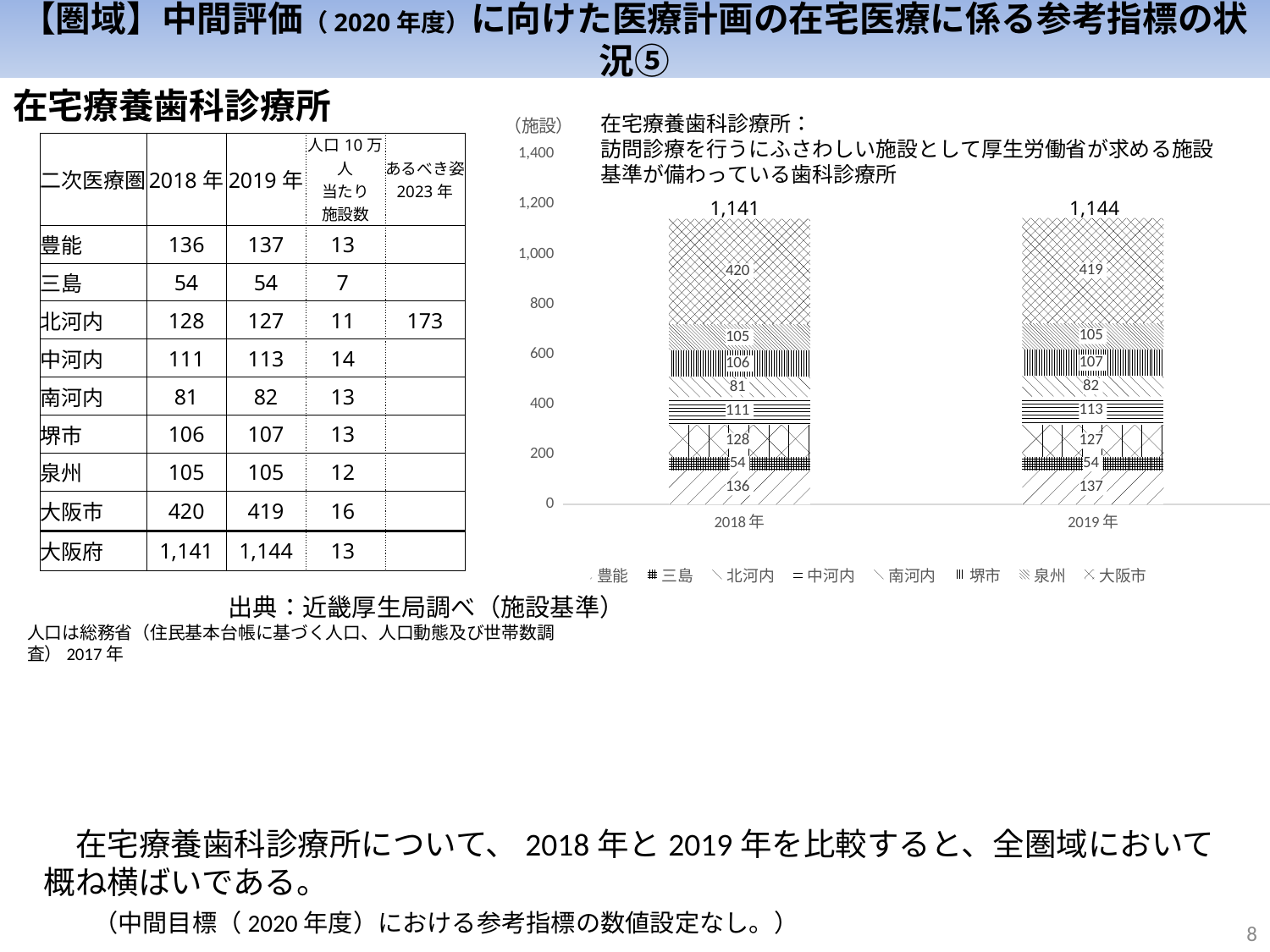
What is the value for 北河内 in the 2019年 bar? 127 What is the value for 大阪市 in the 2018年 bar? 420 What is the total of the stacked bar for 2019年? 1,144 Which series has the smallest segment in the 2019年 bar? 三島 What is the value for 豊能 in the 2019年 bar? 137 How many bars (categories) are plotted on the x axis of the chart? 2 What kind of chart is shown on the slide? stacked bar chart Is the value for 中河内 in the 2018年 bar larger or smaller than the value for 南河内 in the same bar? larger Which series has the largest segment in the 2018年 bar? 大阪市 What is the total of the stacked bar for 2018年? 1,141 How many series does the chart legend list? 8 What is the difference between the 2019年 total and the 2018年 total? 3